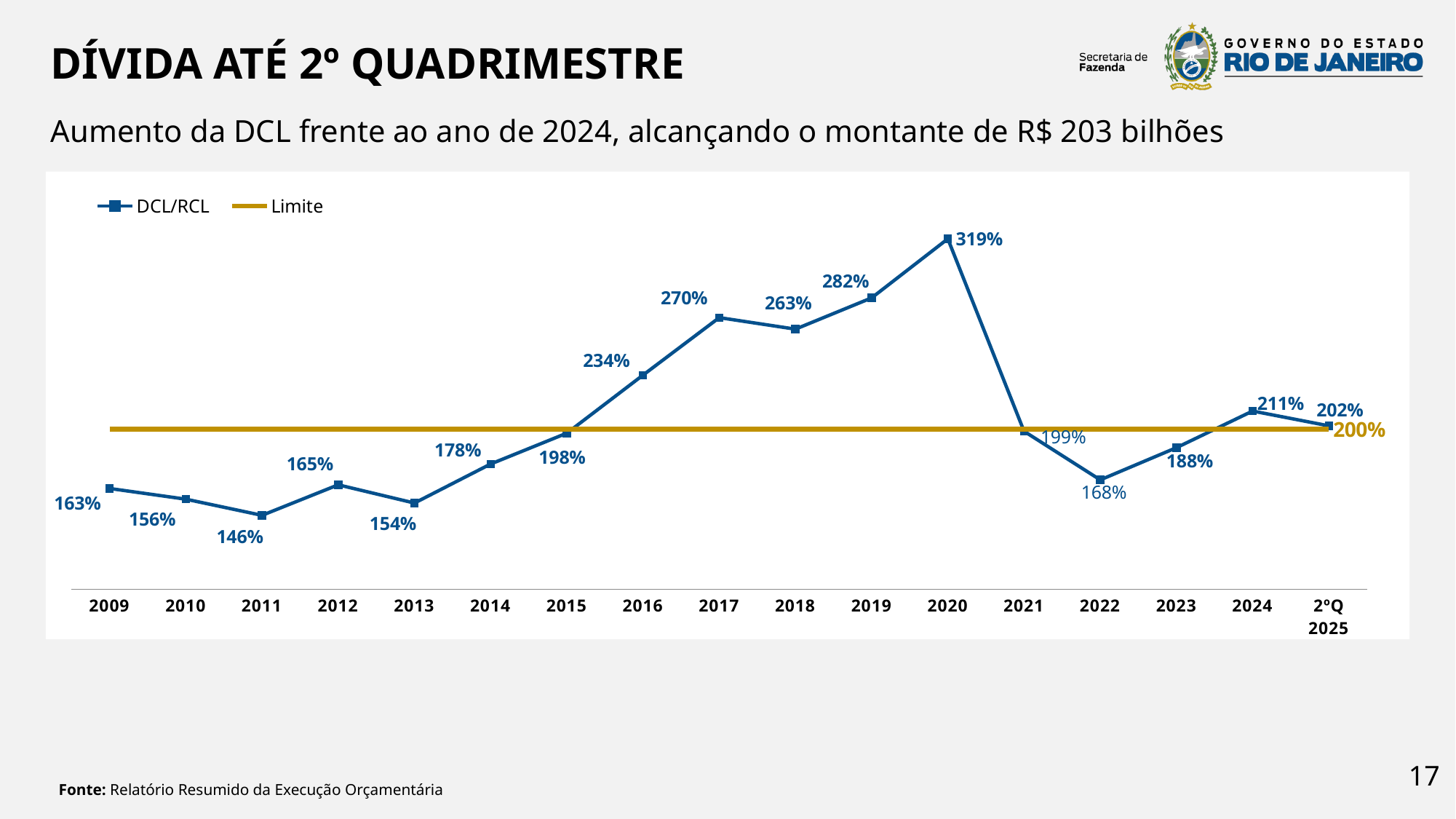
What kind of chart is shown on the slide? Line chart How many points are plotted on the DCL/RCL line? 17 Does the DCL/RCL value rise or fall from 2020 to 2022? Fall What is the DCL/RCL value for 2º Q 2025? 202% What is the difference between the DCL/RCL values for 2020 and 2021? 120% Which is larger, the DCL/RCL value for 2017 or for 2018? 2017 How many series does the legend list? 2 What is the DCL/RCL value for 2011? 146% Which year has the lowest DCL/RCL value? 2011 Which year has the highest DCL/RCL value? 2020 What is the DCL/RCL value for 2020? 319% What value does the Limite line represent? 200%